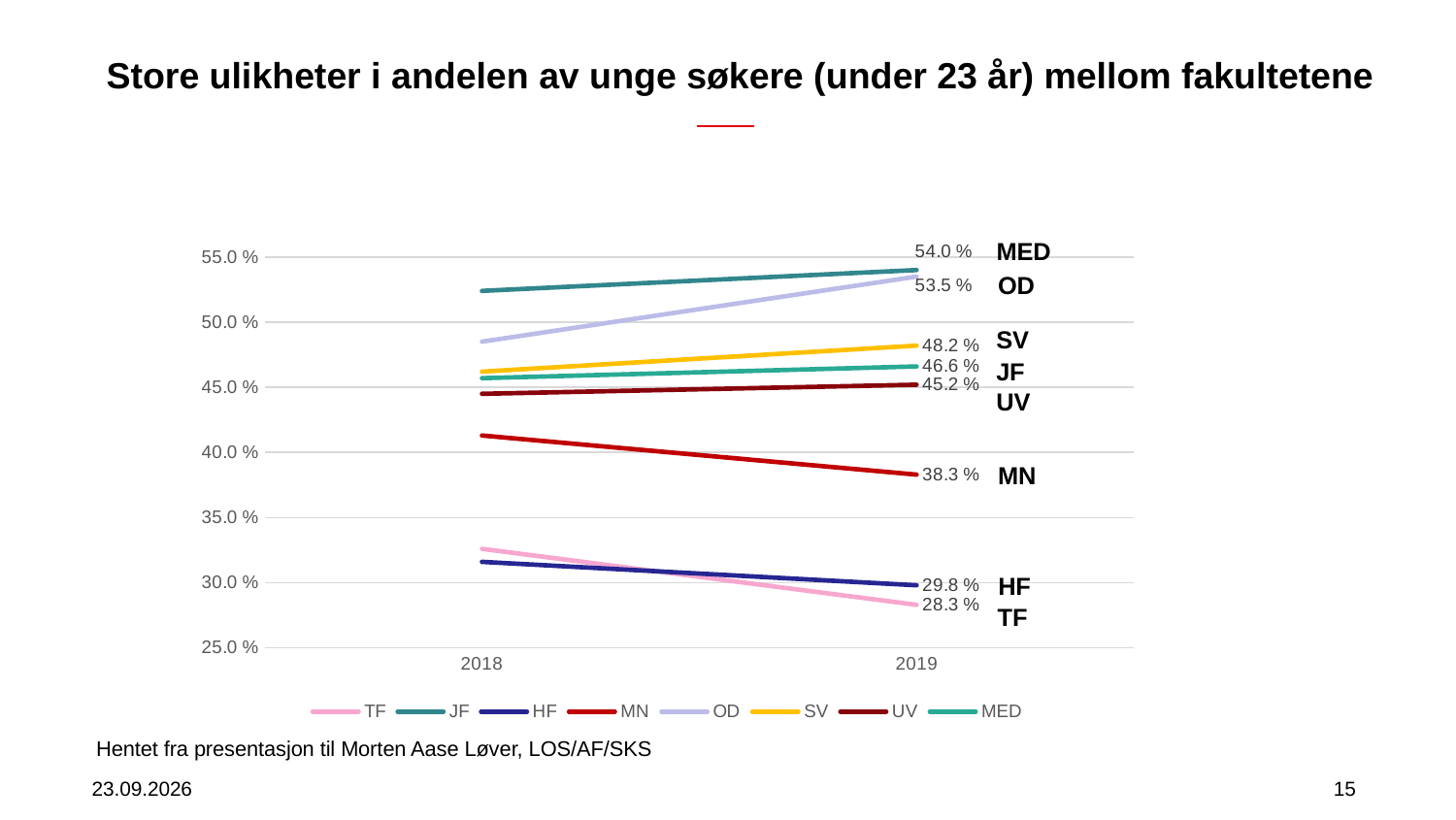
How many series does the legend list? 8 What is the value for MN in 2019? 38.3 % Is the value for MN in 2018 greater or less than 40.0 %? greater What is the difference between HF and TF in 2019? 1.5 % Which faculty has the lowest value in 2019? TF How many years are shown on the x axis? 2 Does the value for MN rise or fall from 2018 to 2019? Fall What kind of chart is shown on the slide? Line chart